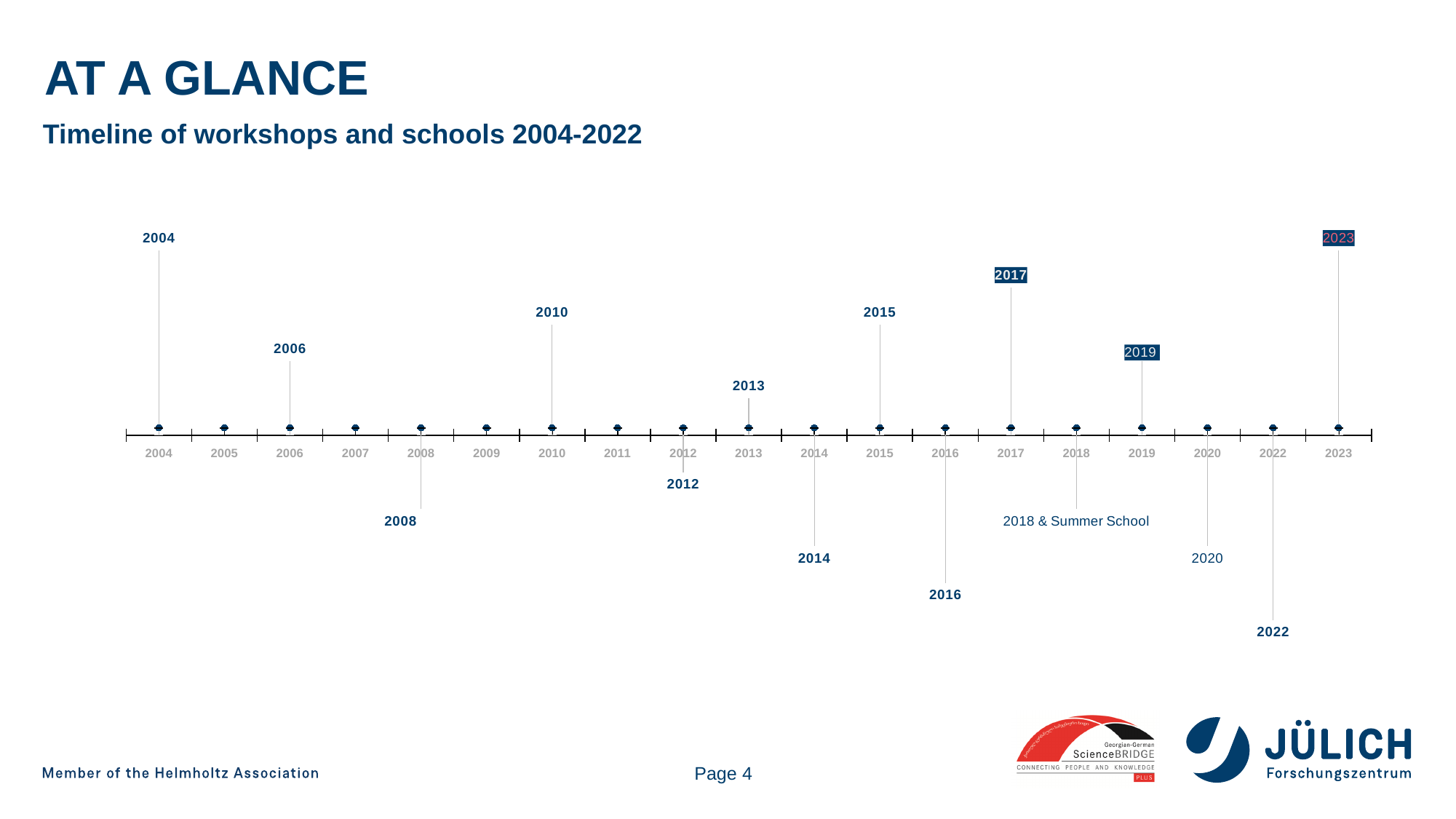
What kind of chart is shown on the slide? A timeline Is the event label for 2022 placed above or below the timeline axis? Below What is the subtitle describing the timeline? Timeline of workshops and schools 2004-2022 Is the event label for 2010 placed above or below the timeline axis? Above How many year ticks are shown along the timeline axis? 20 What is the last year shown on the timeline axis? 2023 Which years on the axis have no event label attached? 2005, 2007, 2009, 2011, 2021 What is the first year shown on the timeline axis? 2004 Which year labels on the timeline are shown inside dark blue boxes? 2017, 2019, 2023 Which year label on the timeline is written in red text? 2023 How many labelled events are marked on the timeline? 15 Which year's label on the timeline also mentions a Summer School? 2018